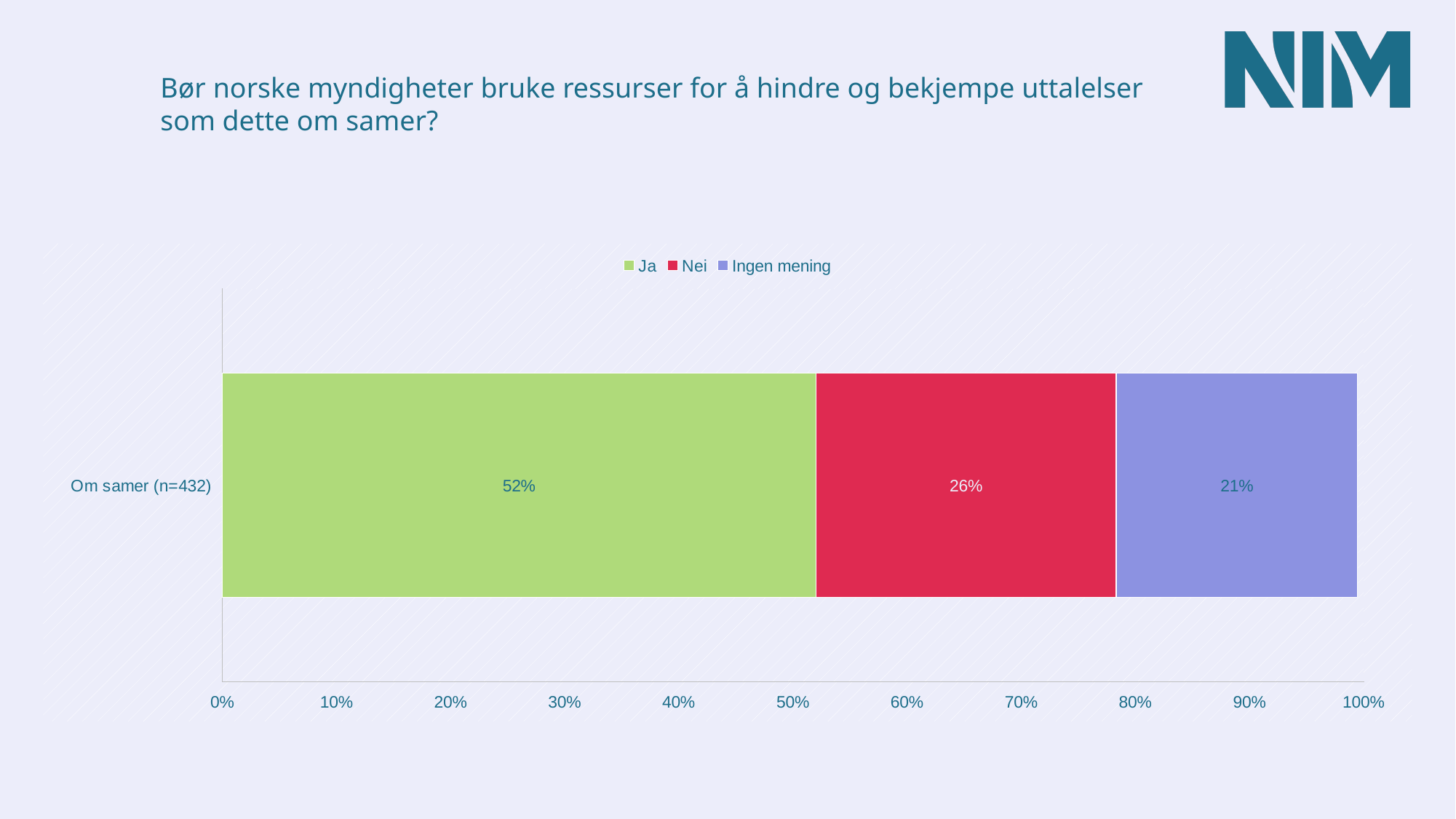
How many series does the legend list? 3 Which response has the smallest share for Om samer (n=432)? Ingen mening What colour represents "Nei" in the chart? Red Which response has the largest share for Om samer (n=432)? Ja Is the "Ja" share for Om samer (n=432) greater or less than 50%? greater What percentage answered "Nei" for Om samer (n=432)? 26% What is the difference between the "Ja" and "Nei" shares for Om samer (n=432)? 26 percentage points Which is larger for Om samer (n=432): the "Nei" share or the "Ingen mening" share? Nei What percentage answered "Ja" for Om samer (n=432)? 52% What percentage answered "Ingen mening" for Om samer (n=432)? 21% How many categories are shown on the vertical axis? 1 What kind of chart is shown on the slide? Stacked bar chart